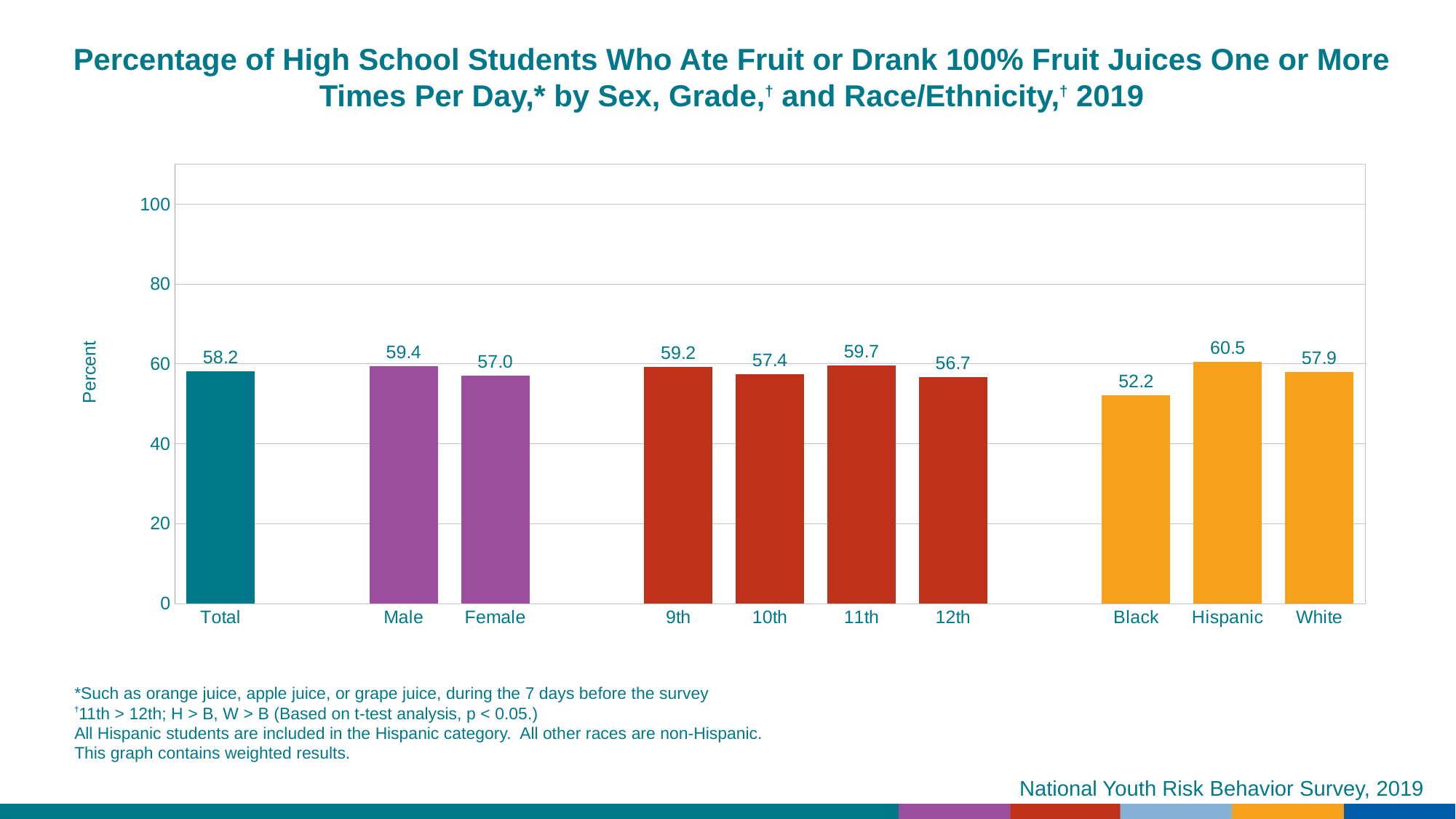
What is the difference between the values for Hispanic and Black students? 8.3 Which is larger, the value for 11th grade or the value for 12th grade? 11th Which category has the lowest value? Black What kind of chart is shown on the slide? bar chart Is the value for Black students greater or less than 60? less What is the difference between the values for Male and Female? 2.4 What is the label of the y axis? Percent Which category has the highest value? Hispanic What is the value for Hispanic students? 60.5 What is the value for Total? 58.2 What is the value for 12th grade students? 56.7 How many categories are shown on the x axis? 10